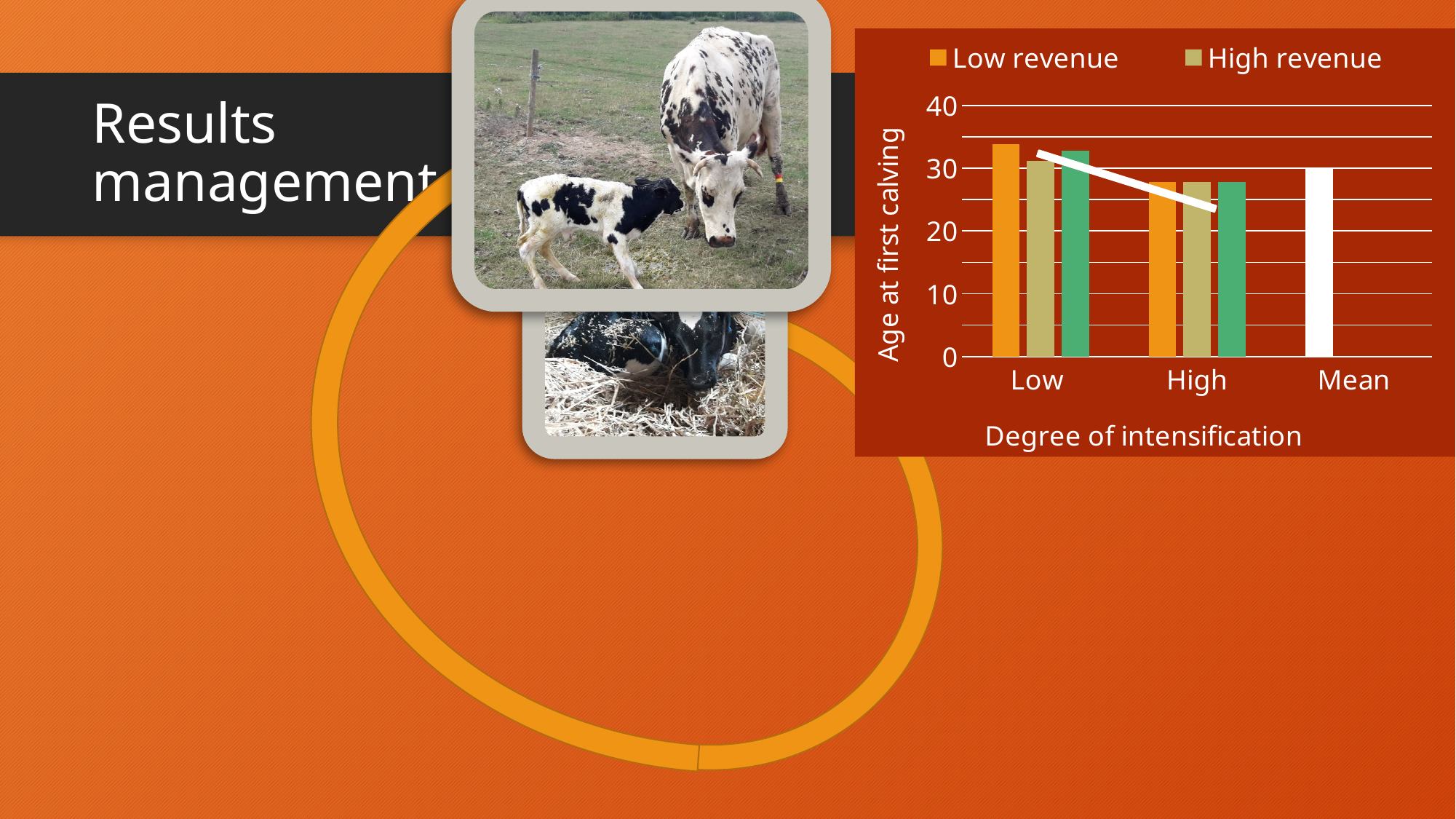
Is the High revenue value for the High degree of intensification greater or less than 30? less For the Low revenue series, which degree of intensification category has the highest value? Low Is the High revenue value for the Low degree of intensification greater or less than 20? greater Is the Low revenue value for the Low degree of intensification greater or less than 30? greater Do the Low revenue values rise or fall from the Low to the High degree of intensification? fall What is the title of the x axis of the chart? Degree of intensification How many series does the chart's legend list? 2 For the Low revenue series, which degree of intensification has the higher value, Low or High? Low What is the title of the y axis of the chart? Age at first calving How many categories are shown on the x axis of the chart? 3 What kind of chart is shown on the slide? bar chart